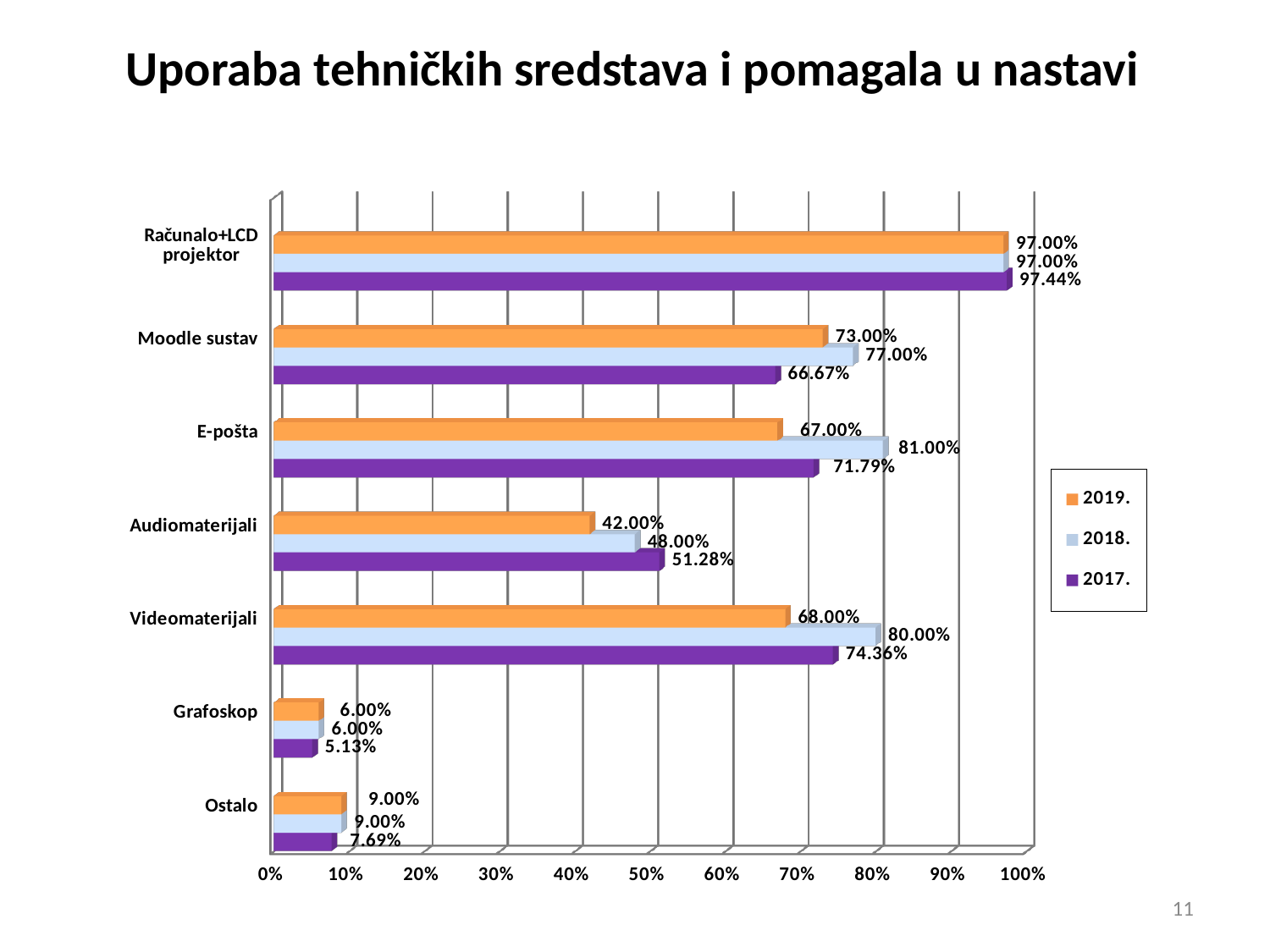
Which is larger for Videomaterijali: the 2018. value or the 2017. value? 2018. What is the title of the slide? Uporaba tehničkih sredstava i pomagala u nastavi How many categories are shown on the chart? 7 Which category has the lowest value in 2018.? Grafoskop How many series does the legend list? 3 What kind of chart is shown on the slide? Bar chart What is the value for Grafoskop in 2017.? 5.13% What is the value for E-pošta in 2017.? 71.79% What is the value for Moodle sustav in 2018.? 77.00% What is the difference between the 2018. and 2019. values for E-pošta? 14.00% Which category has the highest value in 2019.? Računalo+LCD projektor What is the value for Audiomaterijali in 2019.? 42.00%